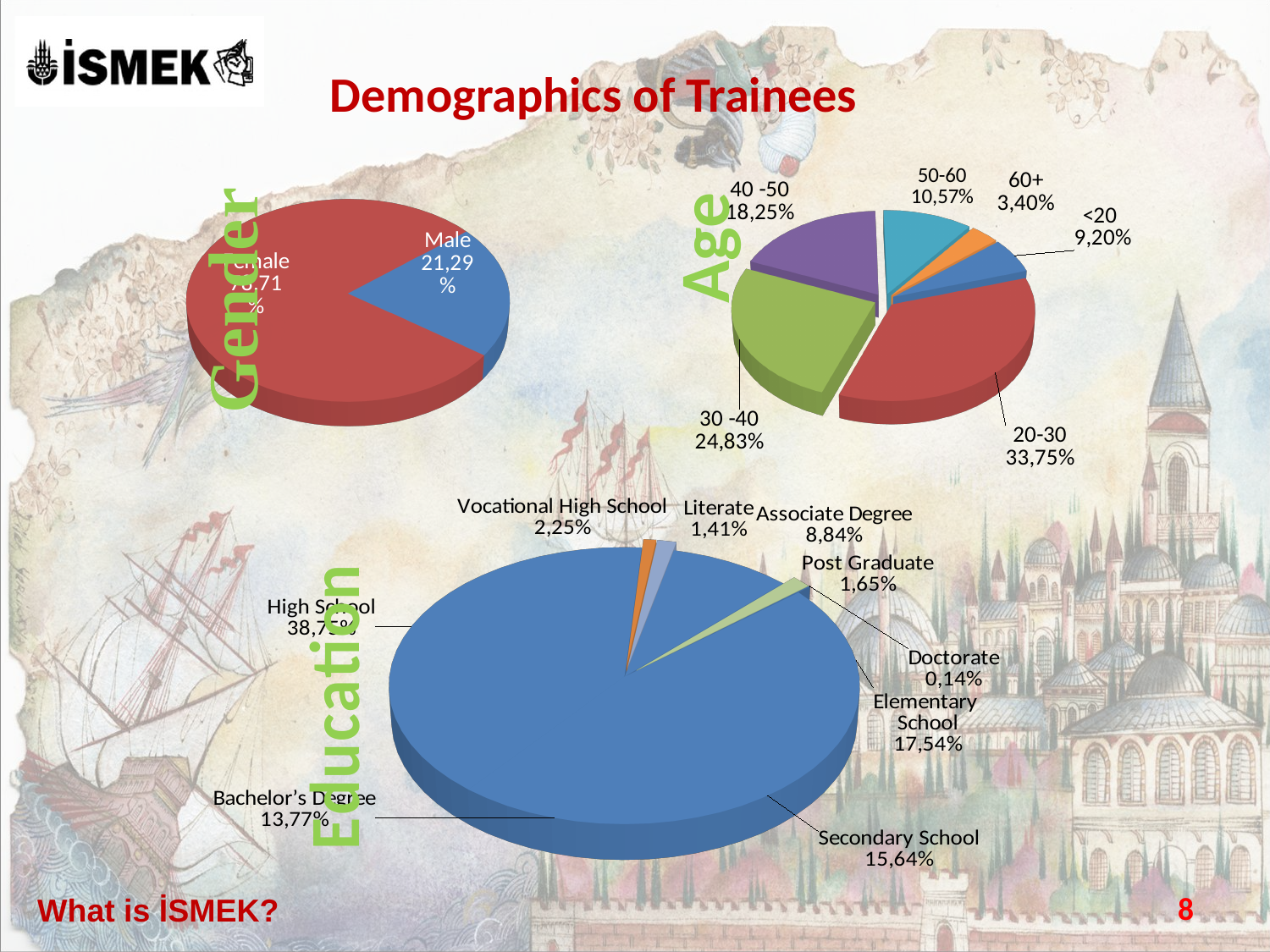
How many age groups are shown in the Age pie chart? 6 In the Age pie chart, what is the value for the 20-30 group? 33,75% In the Education pie chart, which is larger, Elementary School or Secondary School? Elementary School What kind of chart is used for the Education data? Pie chart In the Gender pie chart, which is larger, Female or Male? Female In the Gender pie chart, what is the value for Male? 21,29% In the Education pie chart, what is the value for Doctorate? 0,14% In the Education pie chart, which category has the smallest share? Doctorate In the Age pie chart, which age group has the largest share? 20-30 In the Age pie chart, which age group has the smallest share? 60+ In the Age pie chart, what is the difference between the 30-40 and 40-50 shares? 6,58% In the Age pie chart, what is the value for the 60+ group? 3,40%